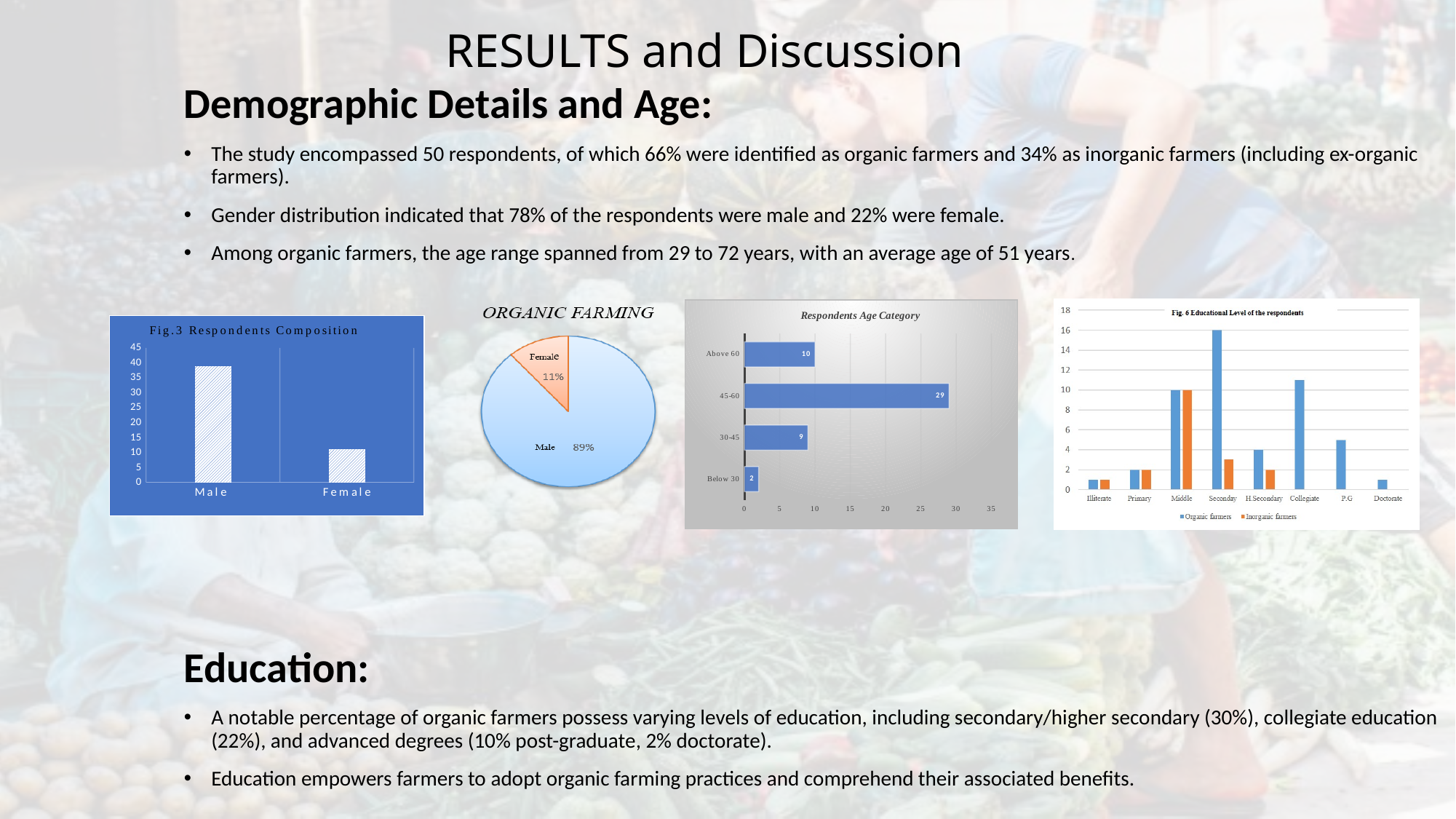
In the Respondents Age Category chart, what is the value for Below 30? 2 In the Respondents Age Category chart, what is the difference between the values for Above 60 and 30-45? 1 In the Fig. 6 Educational Level of the respondents chart, which education level has the highest value for Organic farmers? Seconday In the ORGANIC FARMING pie chart, what share of the pie is Male? 89% In the Fig.3 Respondents Composition chart, is the value for Male greater or less than 30? greater In the Fig.3 Respondents Composition chart, which category is larger, Male or Female? Male In the Respondents Age Category chart, how many age categories are shown? 4 In the ORGANIC FARMING pie chart, what share of the pie is Female? 11% In the Fig. 6 Educational Level of the respondents chart, how many series does the legend list? 2 In the Respondents Age Category chart, which age category has the lowest value? Below 30 In the Respondents Age Category chart, which age category has the highest value? 45-60 In the Respondents Age Category chart, what is the value for the 45-60 category? 29